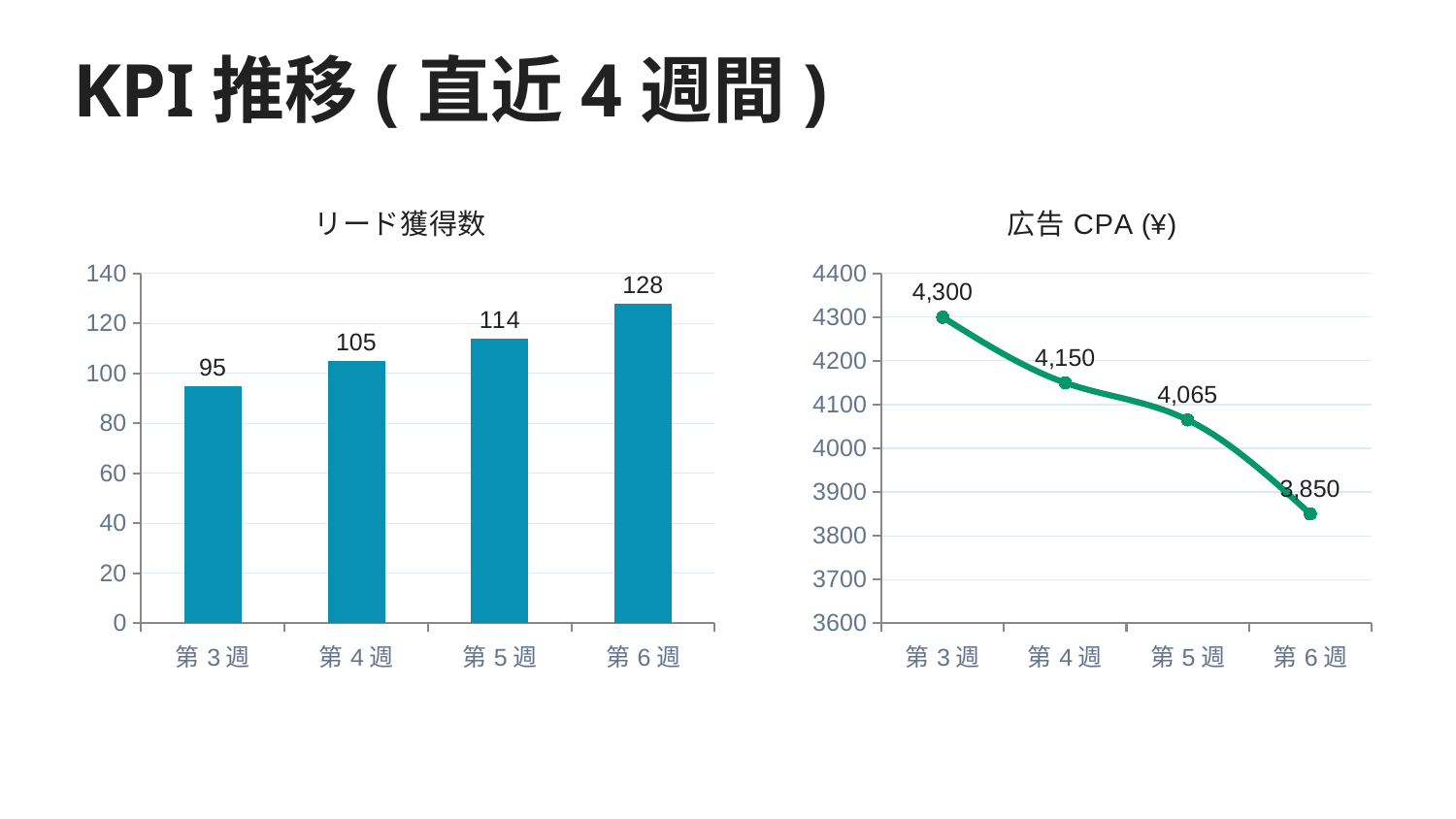
In the リード獲得数 chart, what kind of chart is shown? bar chart In the リード獲得数 chart, which week has the highest value? 第 6 週 In the 広告 CPA (¥) chart, what is the value for 第 4 週? 4,150 In the 広告 CPA (¥) chart, what kind of chart is shown? line chart In the 広告 CPA (¥) chart, what is the value for 第 6 週? 3,850 In the 広告 CPA (¥) chart, how many data points are plotted? 4 In the リード獲得数 chart, what is the difference between 第 6 週 and 第 3 週? 33 In the 広告 CPA (¥) chart, what is the difference between 第 3 週 and 第 5 週? 235 In the 広告 CPA (¥) chart, which week has the lowest value? 第 6 週 In the リード獲得数 chart, do the values rise or fall from 第 3 週 to 第 6 週? rise In the リード獲得数 chart, which week has the lowest value? 第 3 週 In the リード獲得数 chart, what is the value for 第 5 週? 114